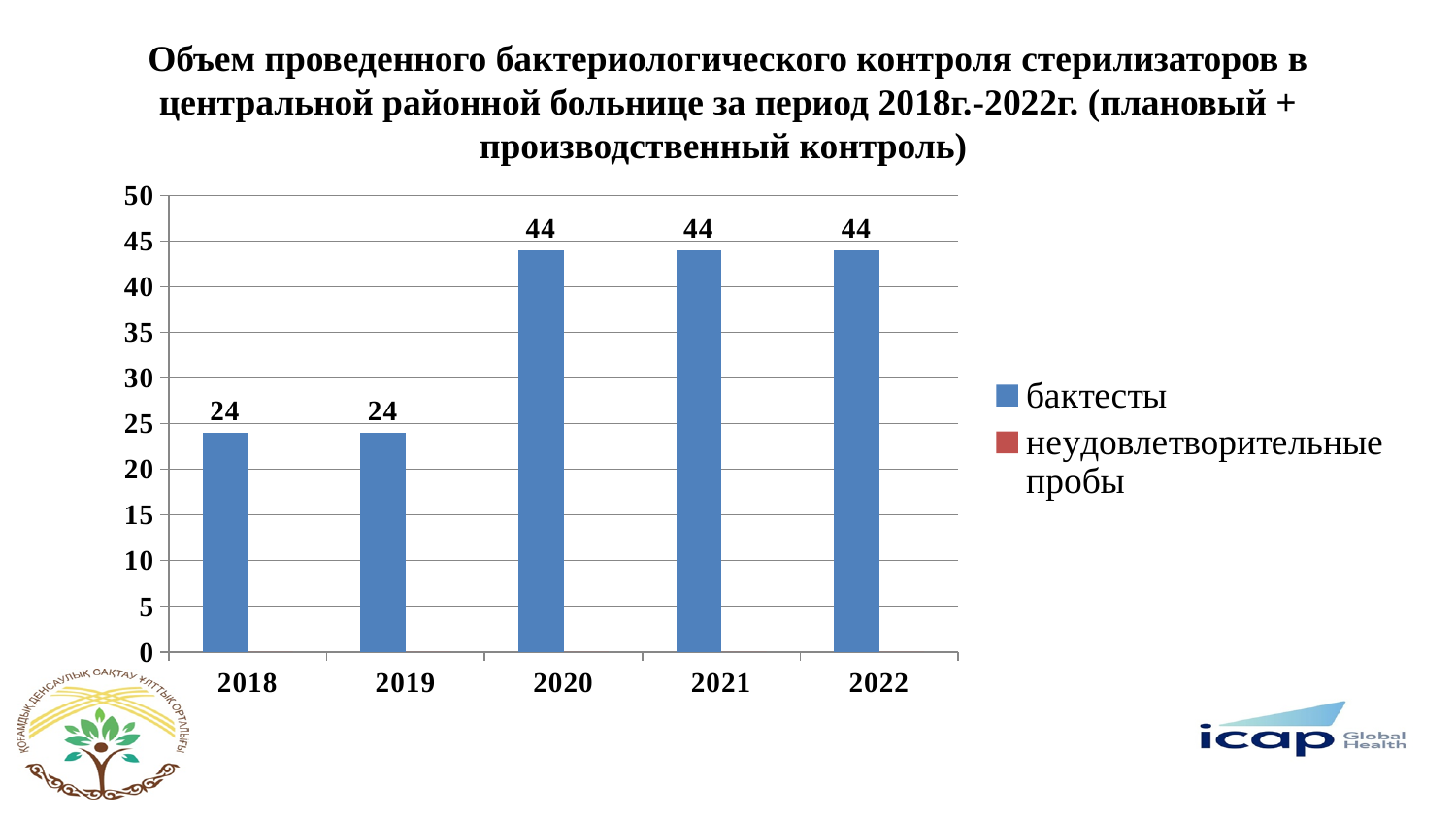
What is the value for бактесты in 2020? 44 What is the value for бактесты in 2022? 44 What is the second entry listed in the legend? неудовлетворительные пробы Which year has the lowest value for бактесты, 2019 or 2021? 2019 Which is larger, the бактесты value for 2018 or for 2021? 2021 How many years are shown on the x axis? 5 Is the value for бактесты in 2019 greater or less than 30? less Do the бактесты values rise or fall from 2019 to 2020? rise What is the value for бактесты in 2018? 24 What is the difference between the бактесты values for 2020 and 2019? 20 What kind of chart is shown on the slide? bar chart How many series does the legend list? 2